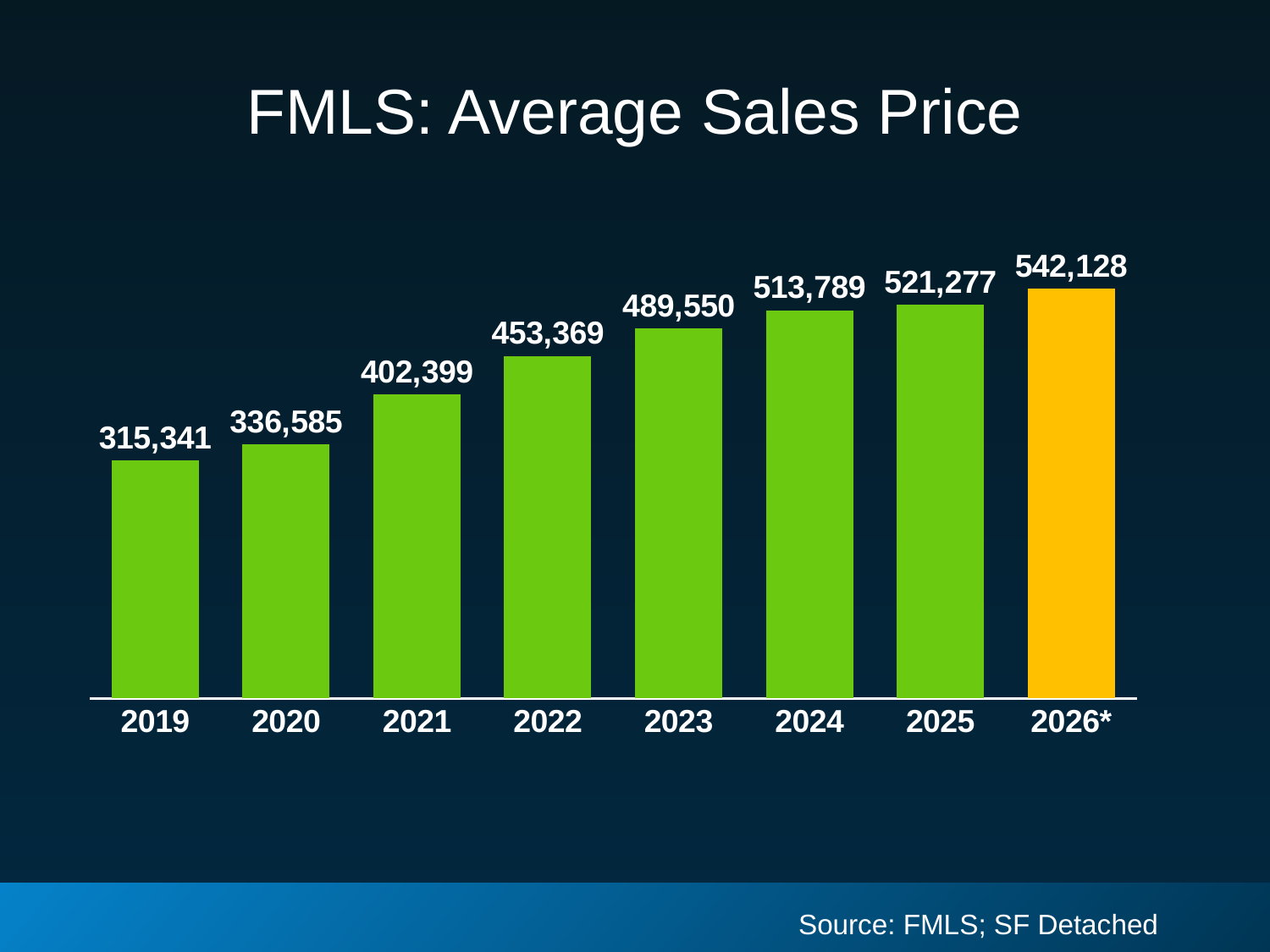
Which is larger, the average sales price in 2021 or in 2023? 2023 Do the average sales prices rise or fall from 2019 to 2026*? Rise What is the difference between the average sales price in 2020 and in 2019? 21,244 What is the average sales price shown for 2026*? 542,128 Which year has the highest average sales price? 2026* How many years are shown on the chart? 8 Which year has the lowest average sales price? 2019 What is the average sales price shown for 2022? 453,369 What is the average sales price shown for 2019? 315,341 What kind of chart is shown on the slide? Bar chart What is the difference between the average sales price in 2025 and in 2024? 7,488 Which bar is coloured differently from the others? 2026*